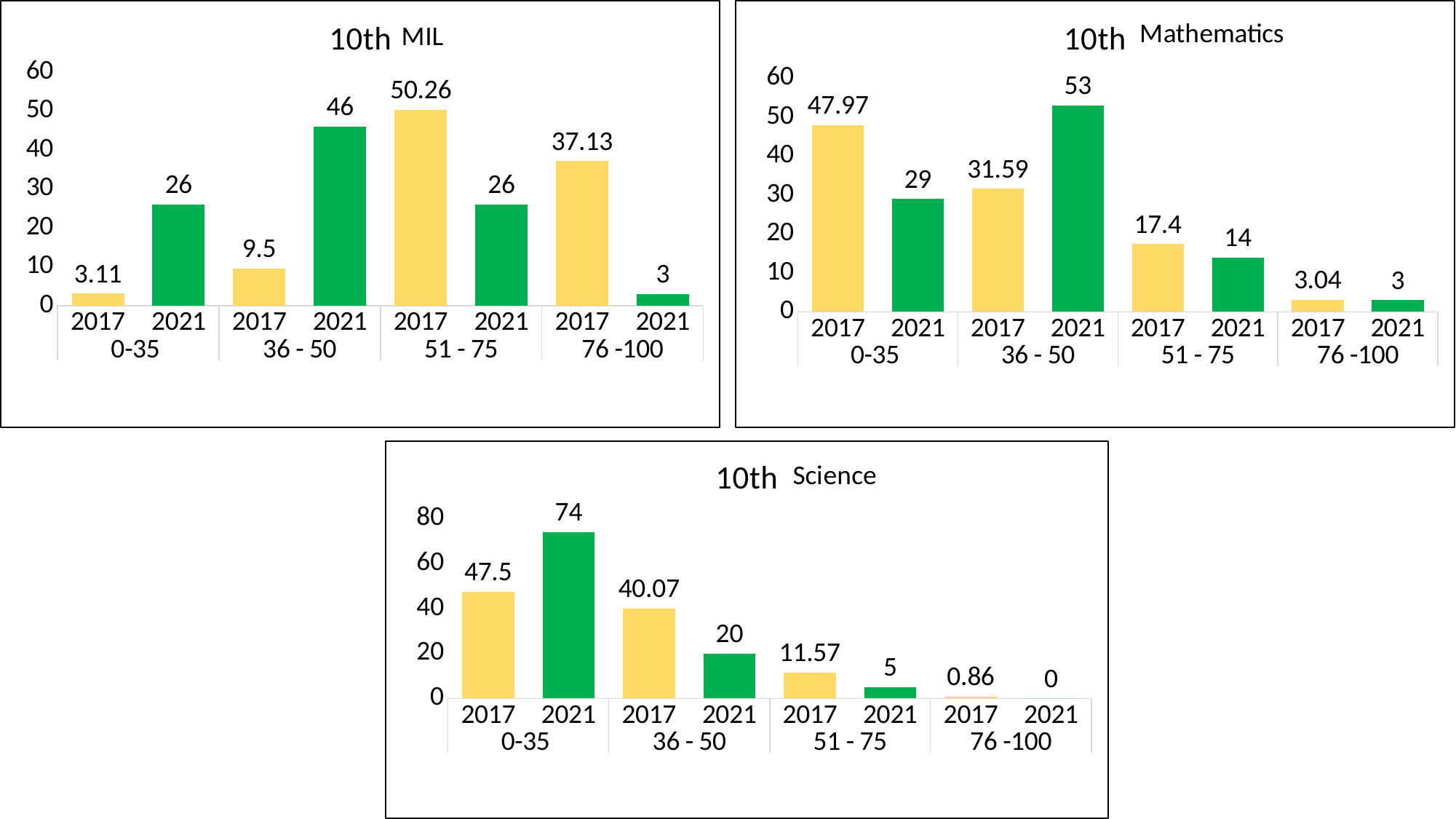
In the '10th Science' chart, what is the value for 2017 in the 36 - 50 range? 40.07 In the '10th Science' chart, what is the value for 2021 in the 76 -100 range? 0 How many bars are plotted in the '10th Science' chart? 8 What type of chart is the '10th Mathematics' chart? bar chart In the '10th MIL' chart, which bar has the lowest value? 2021 in 76 -100 In the '10th MIL' chart, what is the value for 2017 in the 51 - 75 range? 50.26 In the '10th Mathematics' chart, what is the value for 2021 in the 36 - 50 range? 53 In the '10th Mathematics' chart, is the value for 2017 in the 36 - 50 range greater or less than 30? greater In the '10th Science' chart, what is the difference between the 2021 and 2017 values in the 0-35 range? 26.5 In the '10th MIL' chart, which is larger: the 2017 value in 76 -100 or the 2021 value in 36 - 50? 2021 value in 36 - 50 In the '10th Science' chart, which bar has the highest value? 2021 in 0-35 In the '10th Mathematics' chart, what is the difference between the 2017 and 2021 values in the 0-35 range? 18.97